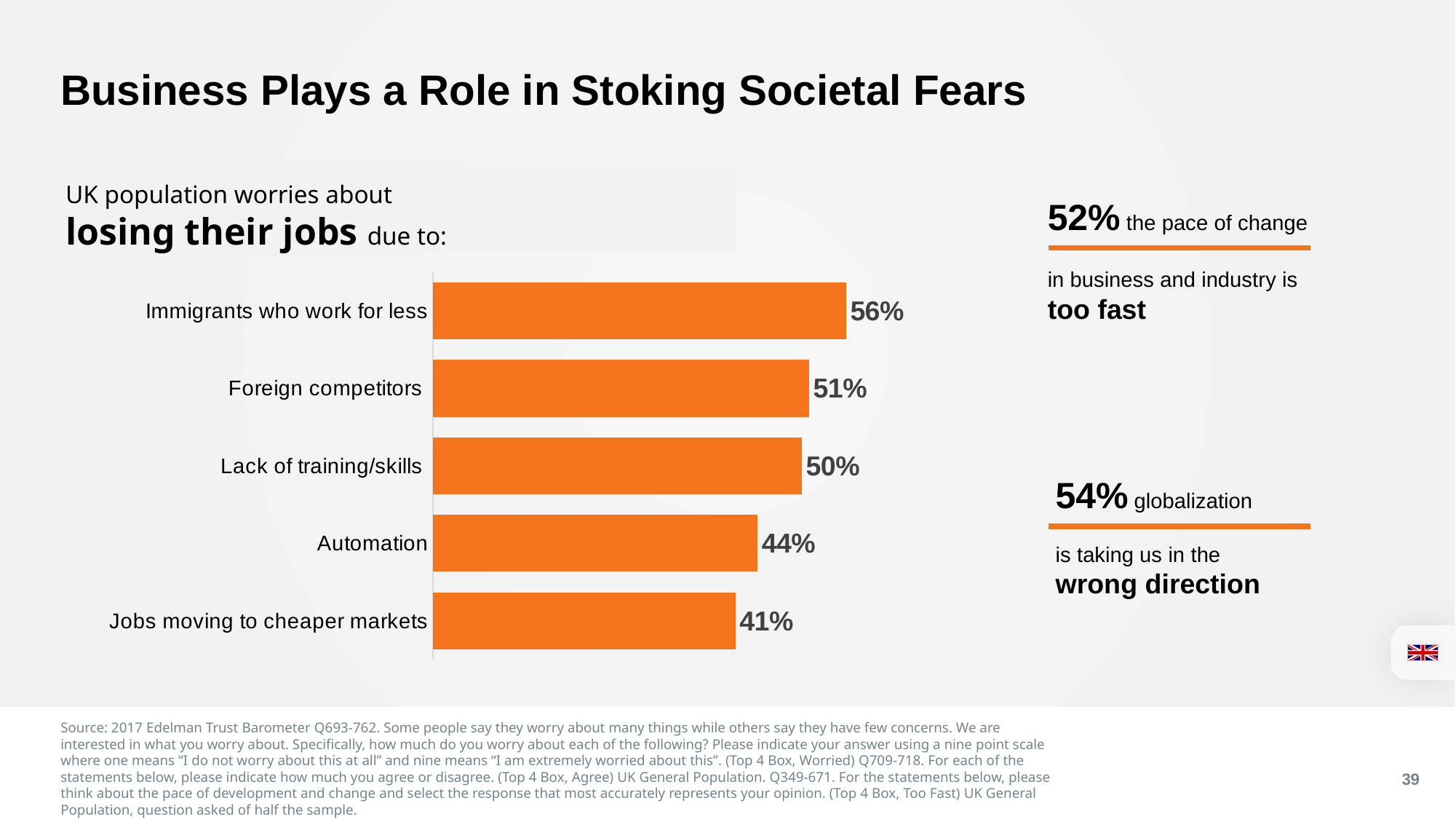
What percentage of the UK population worries about losing their jobs due to immigrants who work for less? 56% What is the value shown for Automation in the bar chart? 44% Which category has the highest value in the bar chart? Immigrants who work for less Which category has the lowest value in the bar chart? Jobs moving to cheaper markets What kind of chart is used to show the job-loss worries? Bar chart What is the difference between the values for Foreign competitors and Automation? 7% What colour are the bars in the chart? Orange Which is larger: the value for Foreign competitors or the value for Lack of training/skills? Foreign competitors What is the difference between the values for Immigrants who work for less and Jobs moving to cheaper markets? 15% Do the values in the bar chart rise or fall from the top category to the bottom category? Fall What is the value shown for Jobs moving to cheaper markets? 41% How many categories are shown in the bar chart? 5